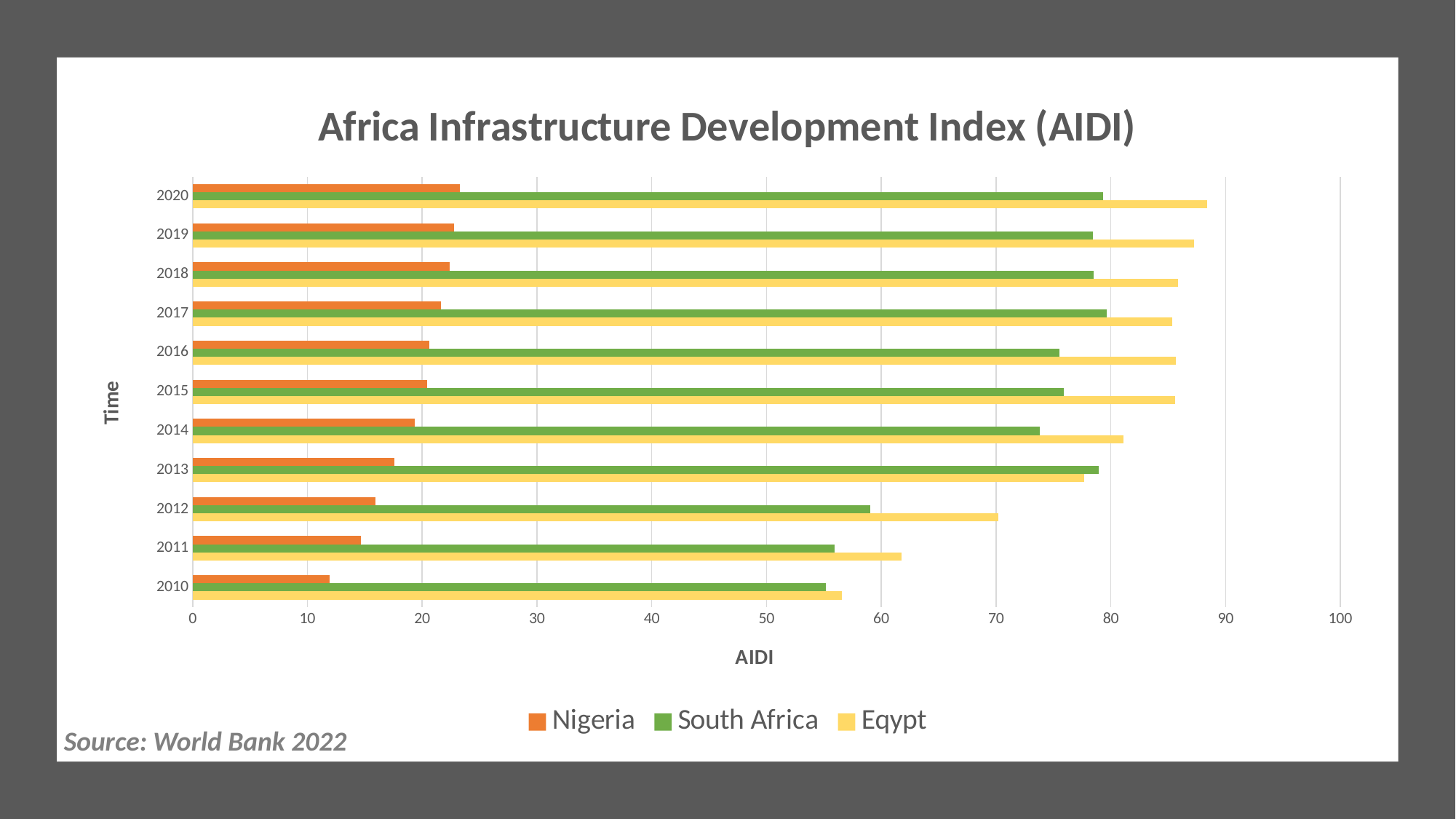
Does Nigeria's AIDI value rise or fall from 2010 to 2020? Rise How many years are shown on the Time axis? 11 Is the value for Nigeria in 2020 greater or less than 20? greater In which year is Nigeria's AIDI value lowest? 2010 What is the label on the horizontal axis? AIDI In 2012, which has the larger AIDI value, South Africa or Egypt? Egypt What kind of chart is shown on the slide? Bar chart Is the value for South Africa in 2013 greater or less than 70? greater Is the value for Nigeria in 2010 greater or less than 20? less In which year is Egypt's AIDI value highest? 2020 How many series does the legend list? 3